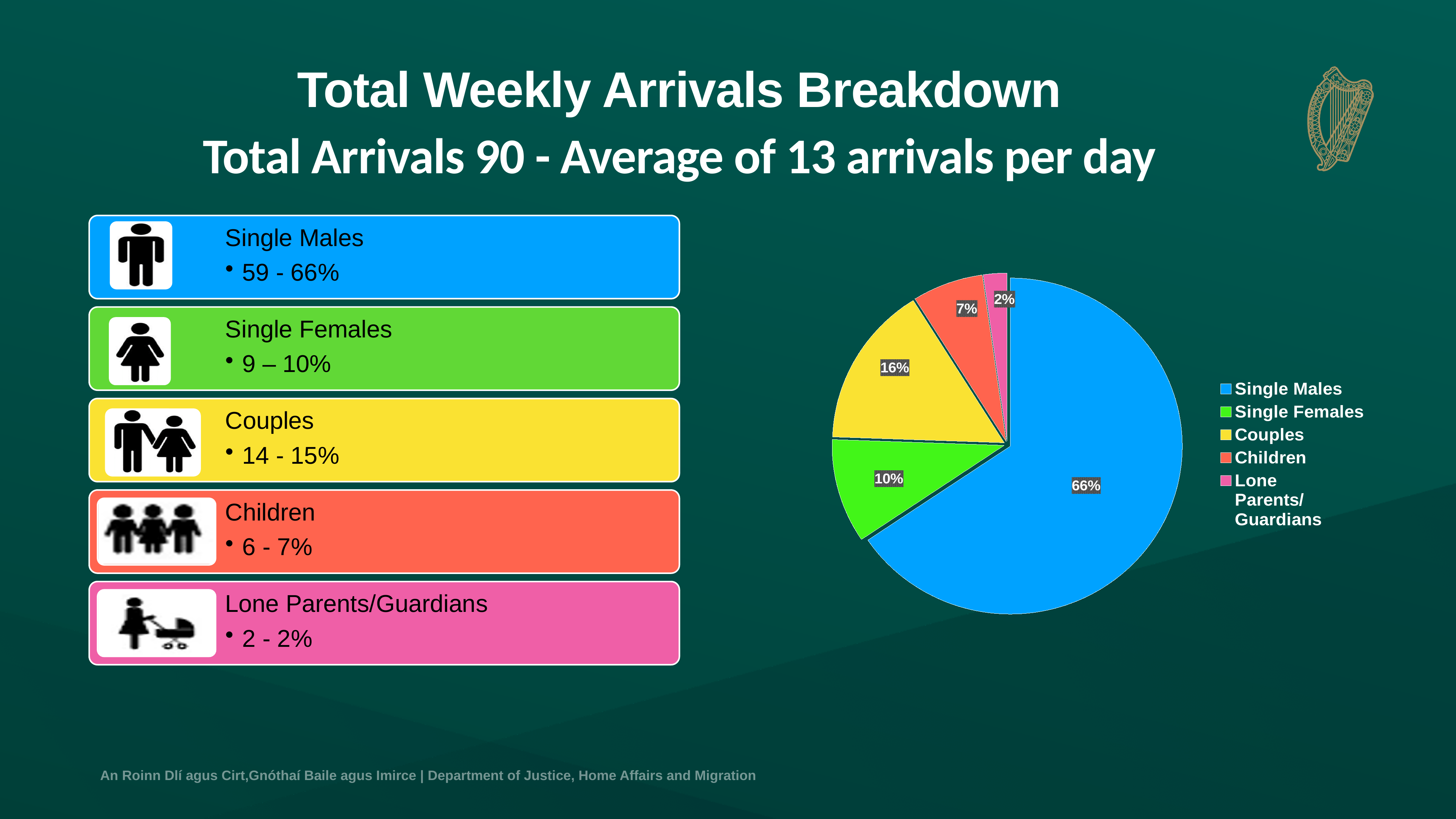
Which category has the largest slice of the pie chart? Single Males What is the difference in percentage points between the Single Males slice and the Couples slice? 50 What percentage of the pie chart is Couples? 16% What percentage of the pie chart is Single Males? 66% What percentage of the pie chart is Children? 7% What kind of chart is shown on the slide? pie chart What colour is the Children slice in the pie chart? red/orange What percentage of the pie chart is Lone Parents/Guardians? 2% Which category has the smallest slice of the pie chart? Lone Parents/Guardians What percentage of the pie chart is Single Females? 10% How many categories does the pie chart legend list? 5 Which slice is larger in the pie chart, Couples or Single Females? Couples